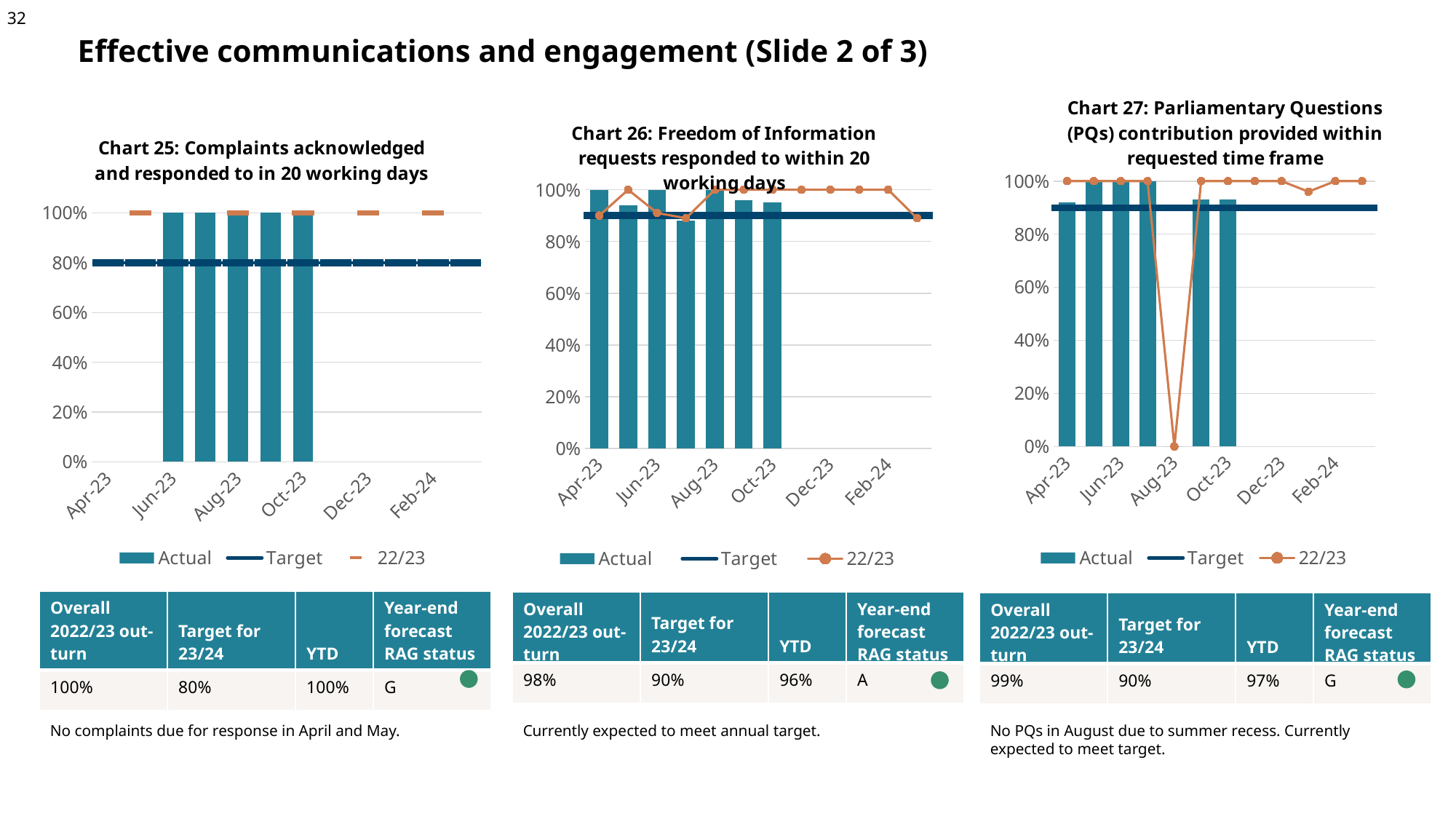
In Chart 27: Parliamentary Questions (PQs) contribution provided within requested time frame, which month has the lowest 22/23 value? Aug-23 What are the three legend entries shown under Chart 27: Parliamentary Questions (PQs) contribution provided within requested time frame? Actual, Target, 22/23 In Chart 25: Complaints acknowledged and responded to in 20 working days, how many months have an Actual bar plotted? 5 What kind of chart is Chart 25: Complaints acknowledged and responded to in 20 working days? bar chart In Chart 25: Complaints acknowledged and responded to in 20 working days, what value does the Target line sit at? 80% In Chart 26: Freedom of Information requests responded to within 20 working days, which is larger, the Actual value for Apr-23 or for Jul-23? Apr-23 In Chart 26: Freedom of Information requests responded to within 20 working days, how many months have an Actual bar plotted? 7 In Chart 27: Parliamentary Questions (PQs) contribution provided within requested time frame, what is the 22/23 value for Aug-23? 0% In Chart 26: Freedom of Information requests responded to within 20 working days, is the Actual value for Jul-23 greater or less than 100%? less How many series does the legend of Chart 26: Freedom of Information requests responded to within 20 working days list? 3 In Chart 25: Complaints acknowledged and responded to in 20 working days, what is the Actual value for Jun-23? 100% In Chart 27: Parliamentary Questions (PQs) contribution provided within requested time frame, is the Actual value for Sep-23 greater or less than 80%? greater